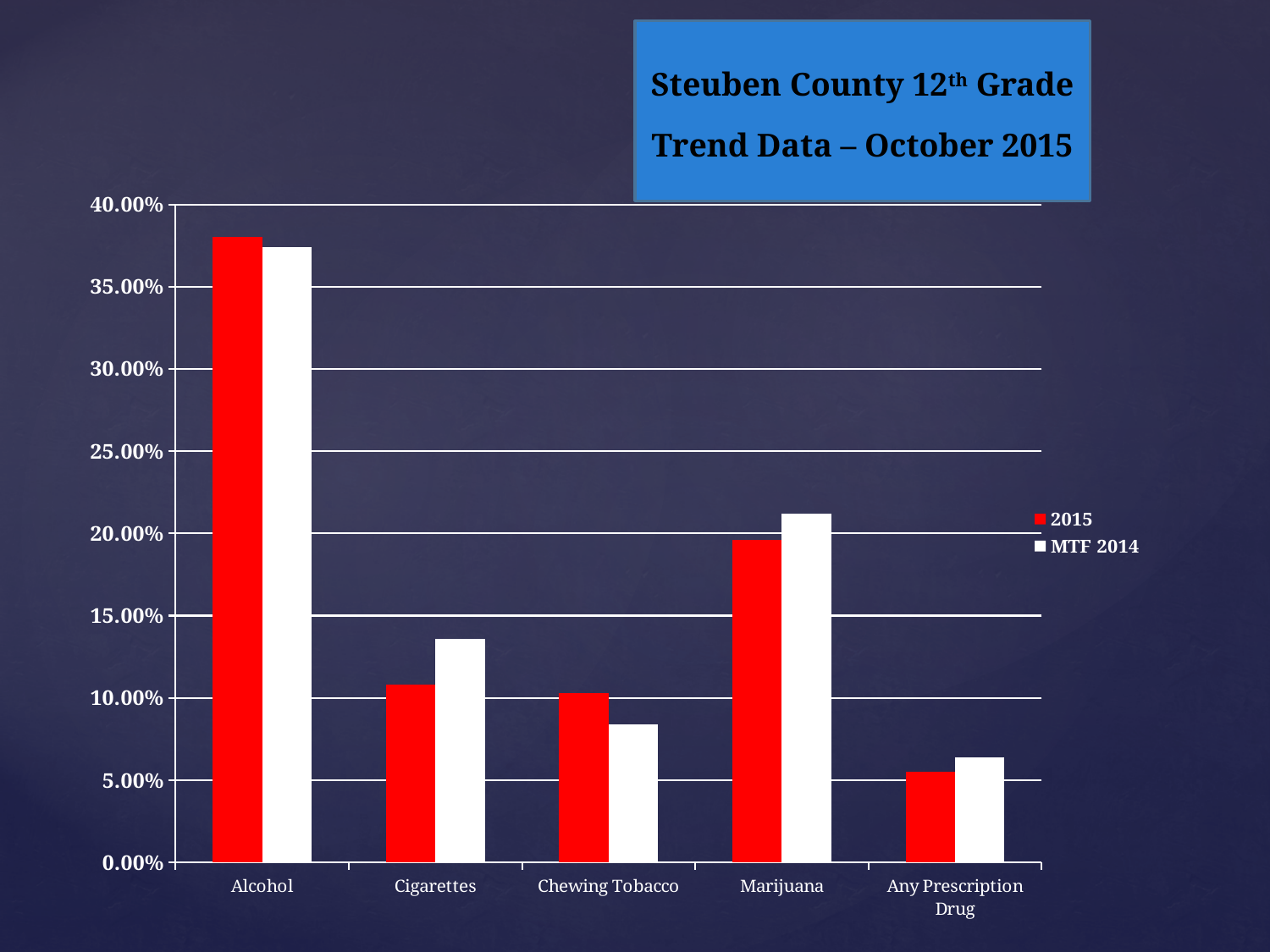
Is the MTF 2014 value for Marijuana greater or less than 20.00%? greater For Chewing Tobacco, which series has the larger value, 2015 or MTF 2014? 2015 Is the MTF 2014 value for Cigarettes greater or less than 15.00%? less Is the 2015 value for Alcohol greater or less than 35.00%? greater For Cigarettes, which series has the larger value, 2015 or MTF 2014? MTF 2014 Which category has the lowest value for the MTF 2014 series? Any Prescription Drug How many categories are shown on the x axis? 5 How many series does the legend list? 2 What colour are the bars for the 2015 series? red Which category has the highest value for the 2015 series? Alcohol What kind of chart is shown on the slide? bar chart